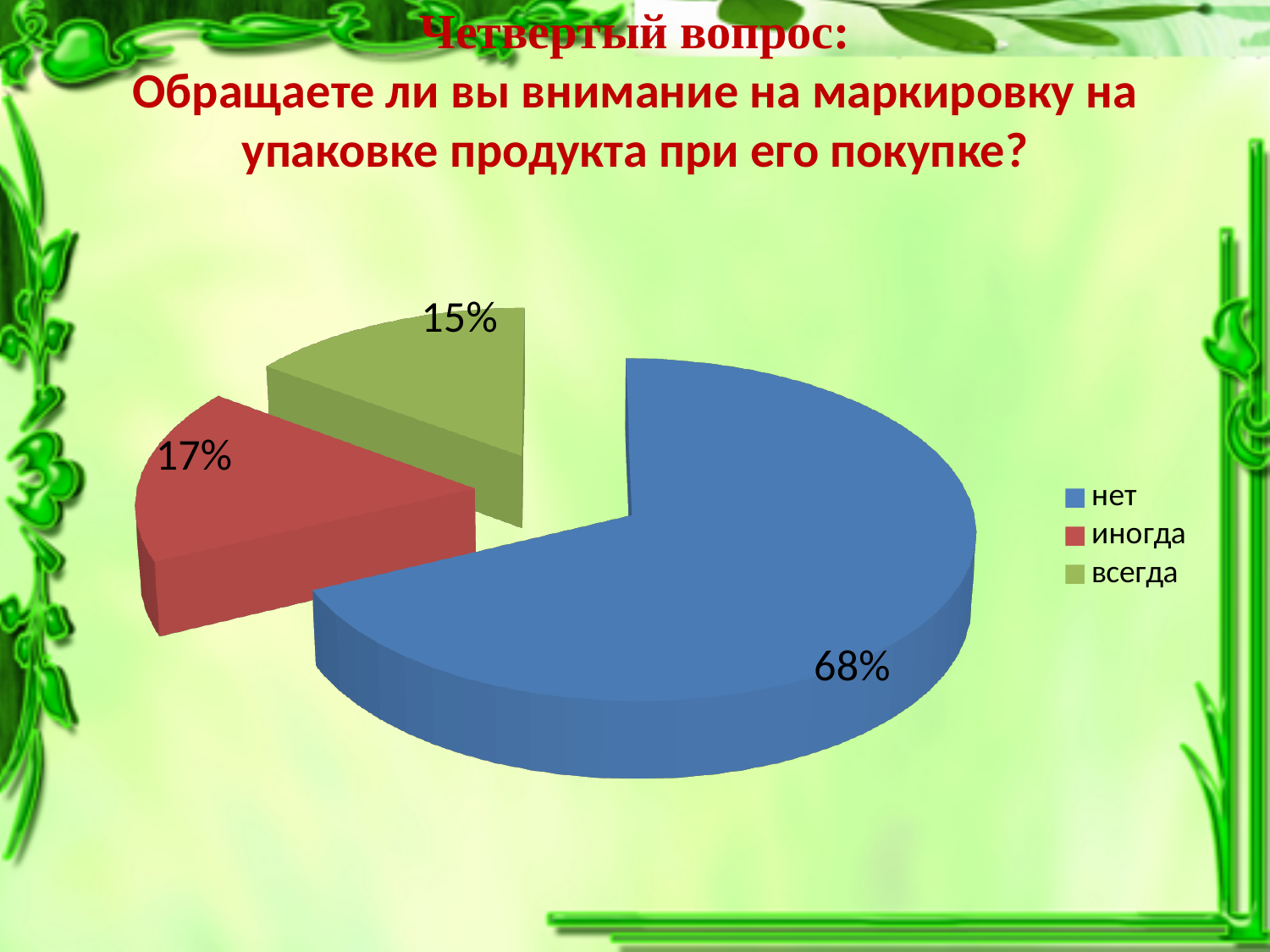
What is the value shown for "всегда"? 15% What is the difference between the values for "иногда" and "всегда"? 2% What colour is the "нет" slice in the pie chart? blue What is the difference between the values for "нет" and "иногда"? 51% Which legend entry is shown in red? иногда Which category has the smallest slice of the pie? всегда What share of the pie does the "нет" slice represent? 68% Which category has the largest slice of the pie? нет What is the value shown for "иногда"? 17% Which is larger, the value for "иногда" or the value for "всегда"? иногда What kind of chart is shown on the slide? pie chart How many categories does the pie chart show? 3